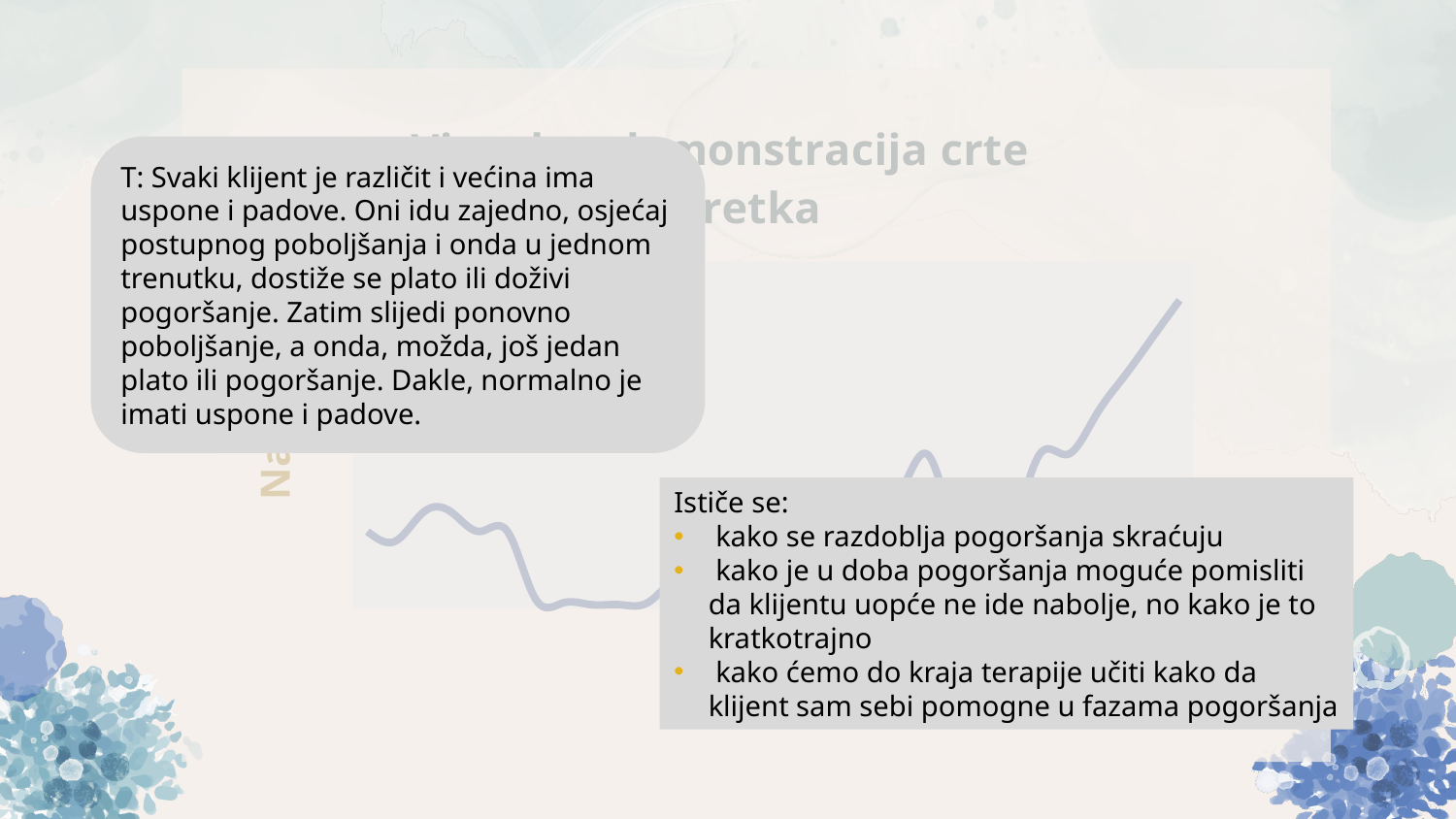
Does the line rise steadily, or does it have ups and downs along the way? ups and downs What kind of chart is shown on the slide? line chart Is the right end of the line higher or lower than its left end? higher Does the chart display any numeric data labels on the line? No Overall, does the plotted line rise or fall from left to right? rises How many lines (series) are plotted on the chart? 1